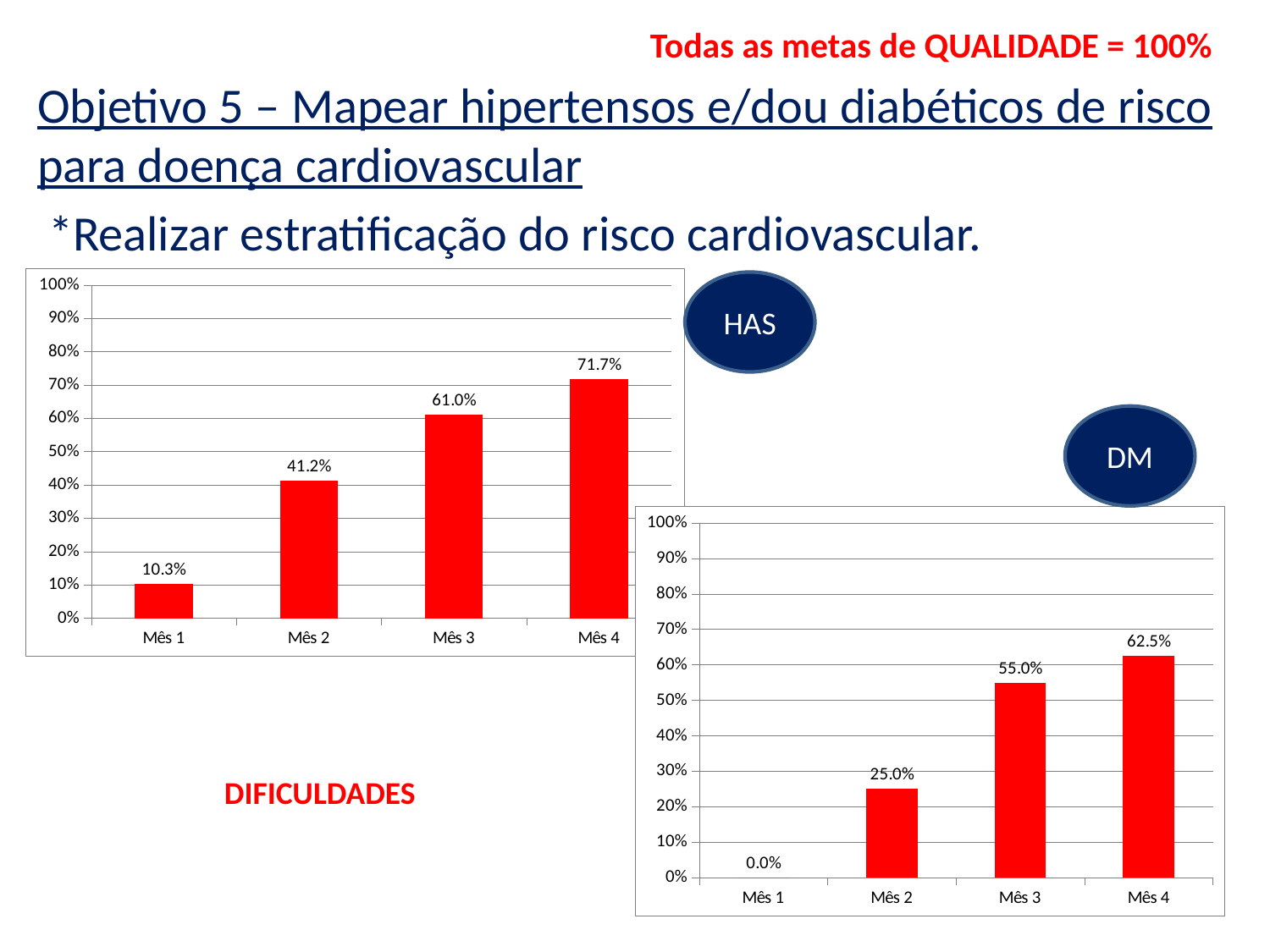
In the HAS chart (upper left), what is the difference between the values for Mês 4 and Mês 1? 61.4% In the DM chart (lower right), what is the difference between the values for Mês 4 and Mês 3? 7.5% Which is larger: the Mês 4 value in the HAS chart or the Mês 4 value in the DM chart? HAS chart (71.7%) In the HAS chart (upper left), is the value for Mês 2 greater or less than 50%? less In the DM chart (lower right), which month has the lowest value? Mês 1 What kind of chart is the HAS chart (upper left)? Bar chart In the DM chart (lower right), what is the value for Mês 2? 25.0% How many months are shown on the x axis of the DM chart (lower right)? 4 In the DM chart (lower right), do the values rise or fall from Mês 1 to Mês 4? Rise What colour are the bars in both charts on the slide? Red In the HAS chart (upper left), what is the value for Mês 3? 61.0% In the HAS chart (upper left), which month has the highest value? Mês 4